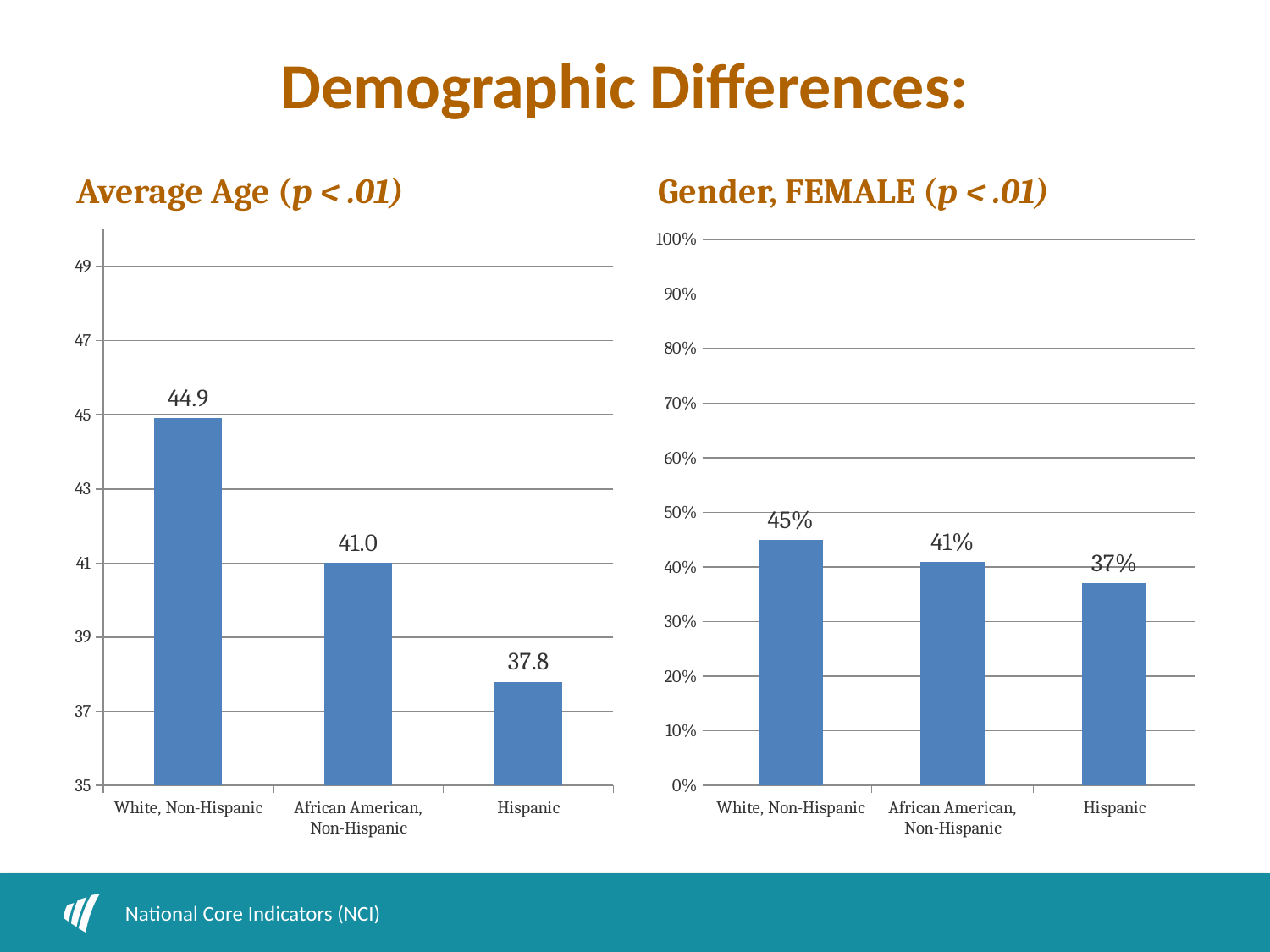
How many categories are shown in the Average Age chart? 3 In the Average Age chart, what is the average age for White, Non-Hispanic? 44.9 In the Average Age chart, what is the difference between the average age for White, Non-Hispanic and Hispanic? 7.1 In the Gender, FEMALE chart, what is the value for African American, Non-Hispanic? 41% In the Gender, FEMALE chart, what is the difference between the values for White, Non-Hispanic and African American, Non-Hispanic? 4% What kind of chart is the Gender, FEMALE chart? Bar chart In the Average Age chart, what is the average age for Hispanic? 37.8 In the Gender, FEMALE chart, which is larger, the value for White, Non-Hispanic or the value for Hispanic? White, Non-Hispanic In the Average Age chart, do the values rise or fall from left to right across the categories? Fall In the Gender, FEMALE chart, what is the value for Hispanic? 37% In the Average Age chart, which category has the highest average age? White, Non-Hispanic In the Gender, FEMALE chart, which category has the lowest percentage? Hispanic